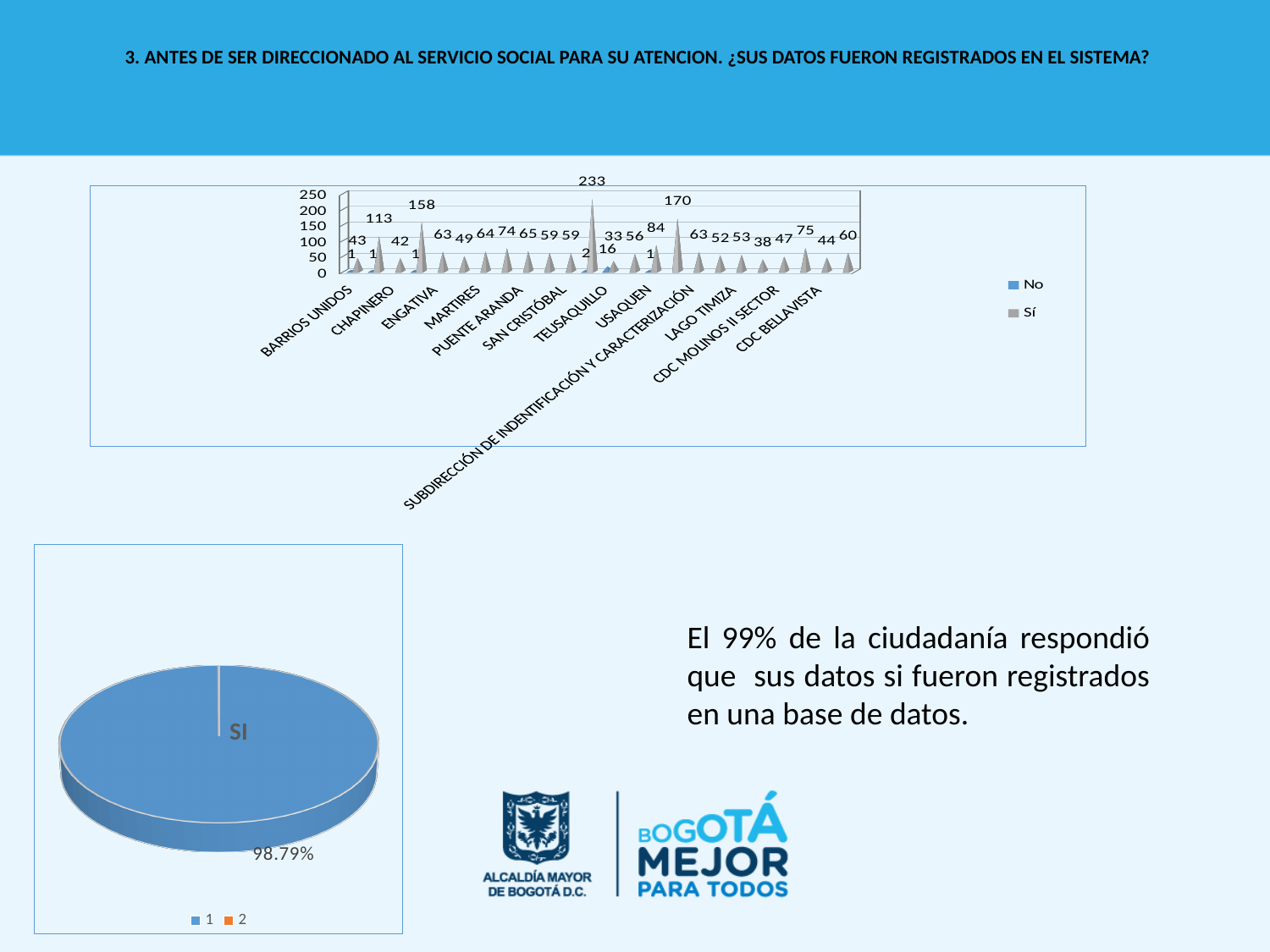
What kind of chart is the top chart on the slide? bar chart In the top chart, what is the highest data label shown? 233 What is the maximum value shown on the vertical axis of the top chart? 250 What percentage is printed on the bottom-left pie chart? 98.79% How many series does the legend of the top chart list? 2 What are the two legend entries of the top chart? No and Sí In the top chart, what is the second highest data label shown? 170 What kind of chart is the bottom-left chart on the slide? pie chart In the top chart, what is the difference between the two highest data labels, 233 and 170? 63 What label appears on the large slice of the bottom-left pie chart? SI In the top chart, is the highest bar greater or less than 200? greater How many entries does the legend of the bottom-left pie chart list? 2